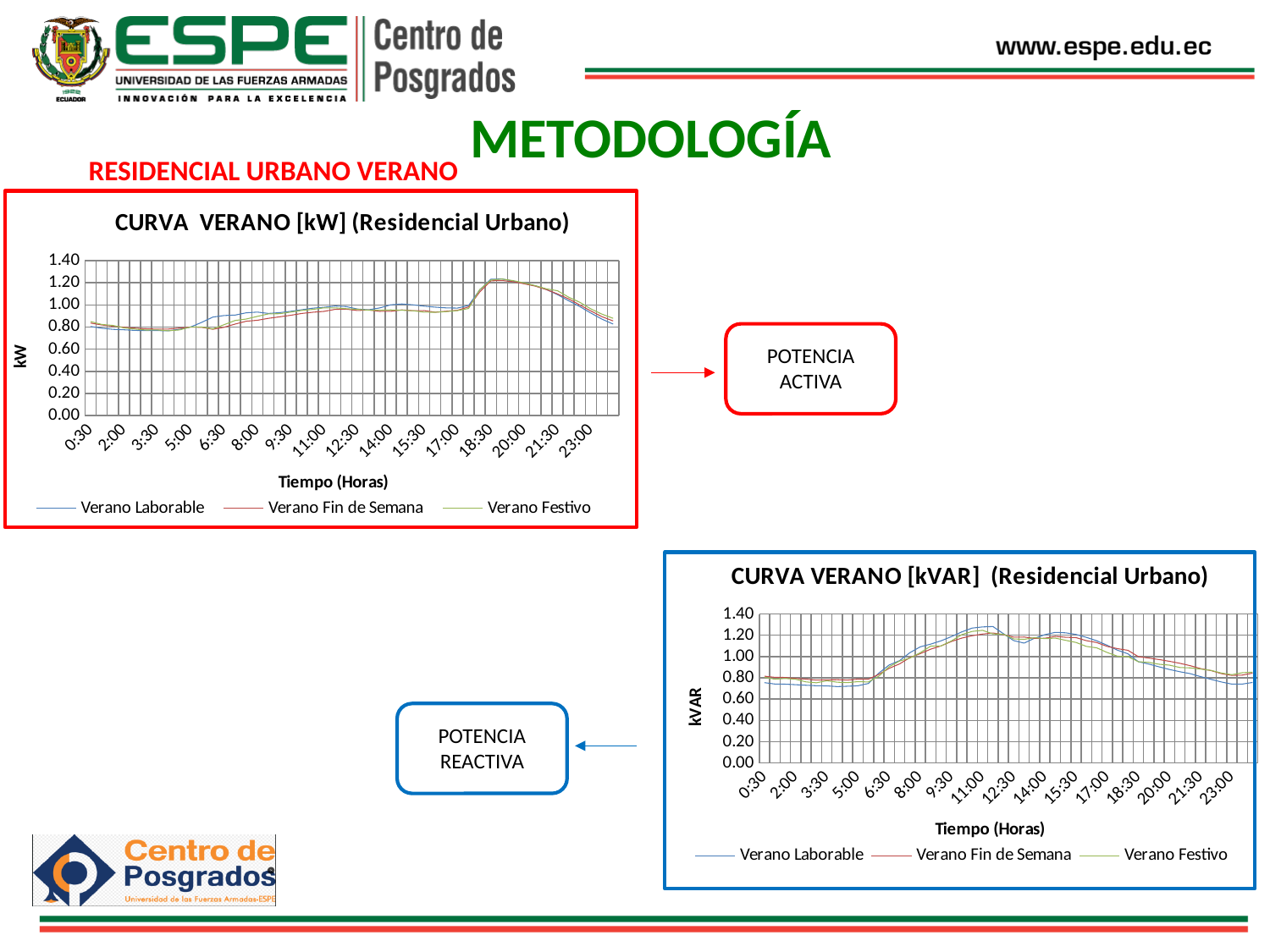
In the 'CURVA VERANO [kW] (Residencial Urbano)' chart, do the values rise or fall between 18:30 and 23:00? fall What is the x-axis title of the 'CURVA VERANO [kVAR] (Residencial Urbano)' chart? Tiempo (Horas) In the 'CURVA VERANO [kVAR] (Residencial Urbano)' chart, is the value for Verano Laborable at 0:30 greater or less than 1.00? less What kind of chart is the 'CURVA VERANO [kVAR] (Residencial Urbano)' chart? line chart In the 'CURVA VERANO [kVAR] (Residencial Urbano)' chart, is the value for Verano Laborable at 11:00 greater or less than 1.00? greater What kind of chart is the 'CURVA VERANO [kW] (Residencial Urbano)' chart? line chart In the 'CURVA VERANO [kW] (Residencial Urbano)' chart, is the value for Verano Laborable at 2:00 greater or less than 1.00? less How many series does the legend of the 'CURVA VERANO [kW] (Residencial Urbano)' chart list? 3 In the 'CURVA VERANO [kVAR] (Residencial Urbano)' chart, do the values rise or fall between 5:00 and 11:00? rise What is the y-axis label of the 'CURVA VERANO [kW] (Residencial Urbano)' chart? kW How many series does the legend of the 'CURVA VERANO [kVAR] (Residencial Urbano)' chart list? 3